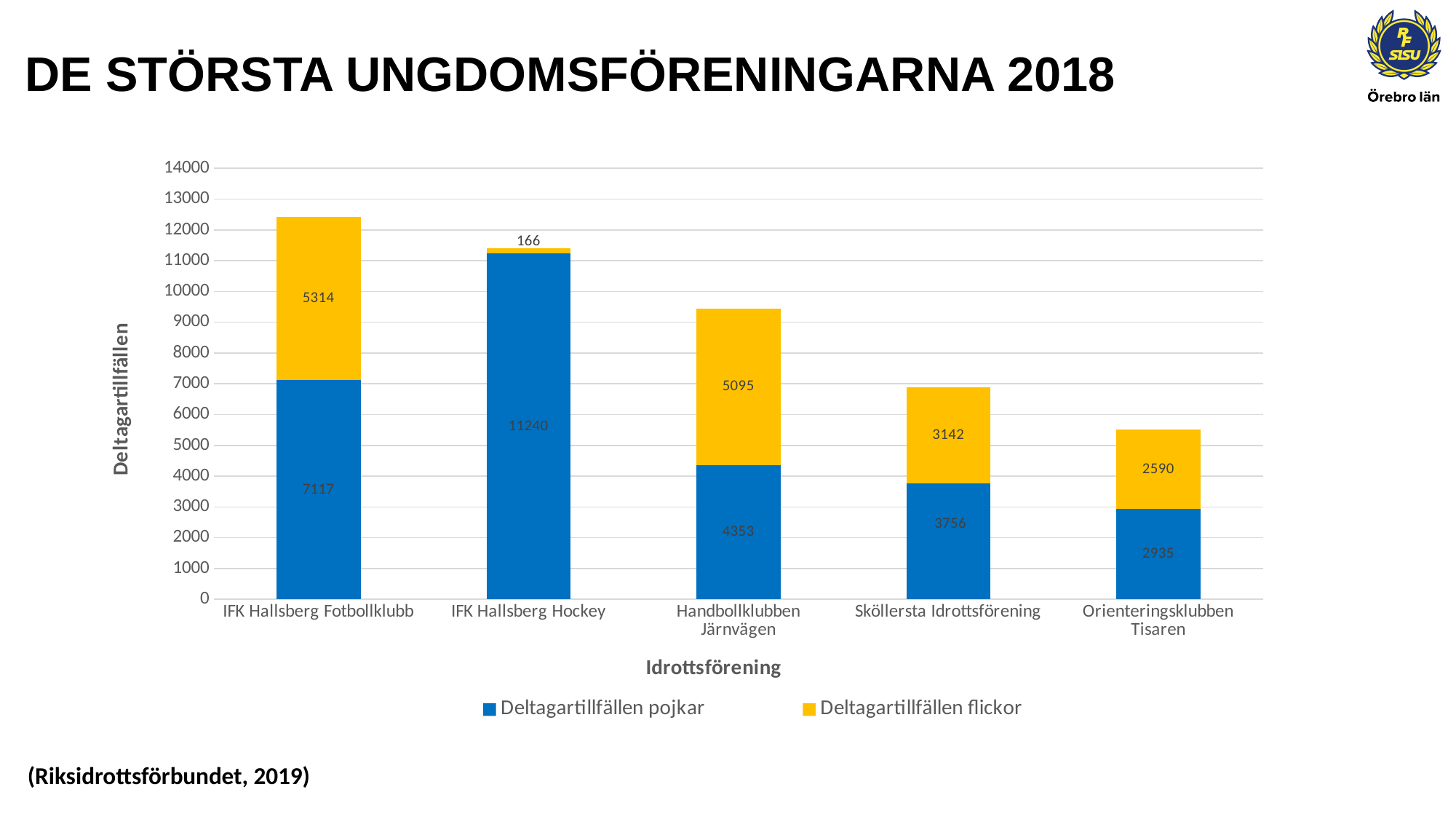
Which club has the highest value for Deltagartillfällen pojkar? IFK Hallsberg Hockey What is the difference between Deltagartillfällen pojkar and Deltagartillfällen flickor for IFK Hallsberg Fotbollklubb? 1803 What type of chart is shown on the slide? Stacked bar chart Which is larger for Handbollklubben Järnvägen: Deltagartillfällen pojkar or Deltagartillfällen flickor? Deltagartillfällen flickor How many sports clubs (categories) are shown on the x axis? 5 What is the total of the stacked bar for Sköllersta Idrottsförening? 6898 What is the value of Deltagartillfällen pojkar for IFK Hallsberg Hockey? 11240 Is the total stacked bar for Orienteringsklubben Tisaren greater or less than 6000? less What is the value of Deltagartillfällen flickor for Handbollklubben Järnvägen? 5095 How many series does the legend list? 2 Which club has the lowest value for Deltagartillfällen flickor? IFK Hallsberg Hockey What is the value of Deltagartillfällen flickor for IFK Hallsberg Hockey? 166